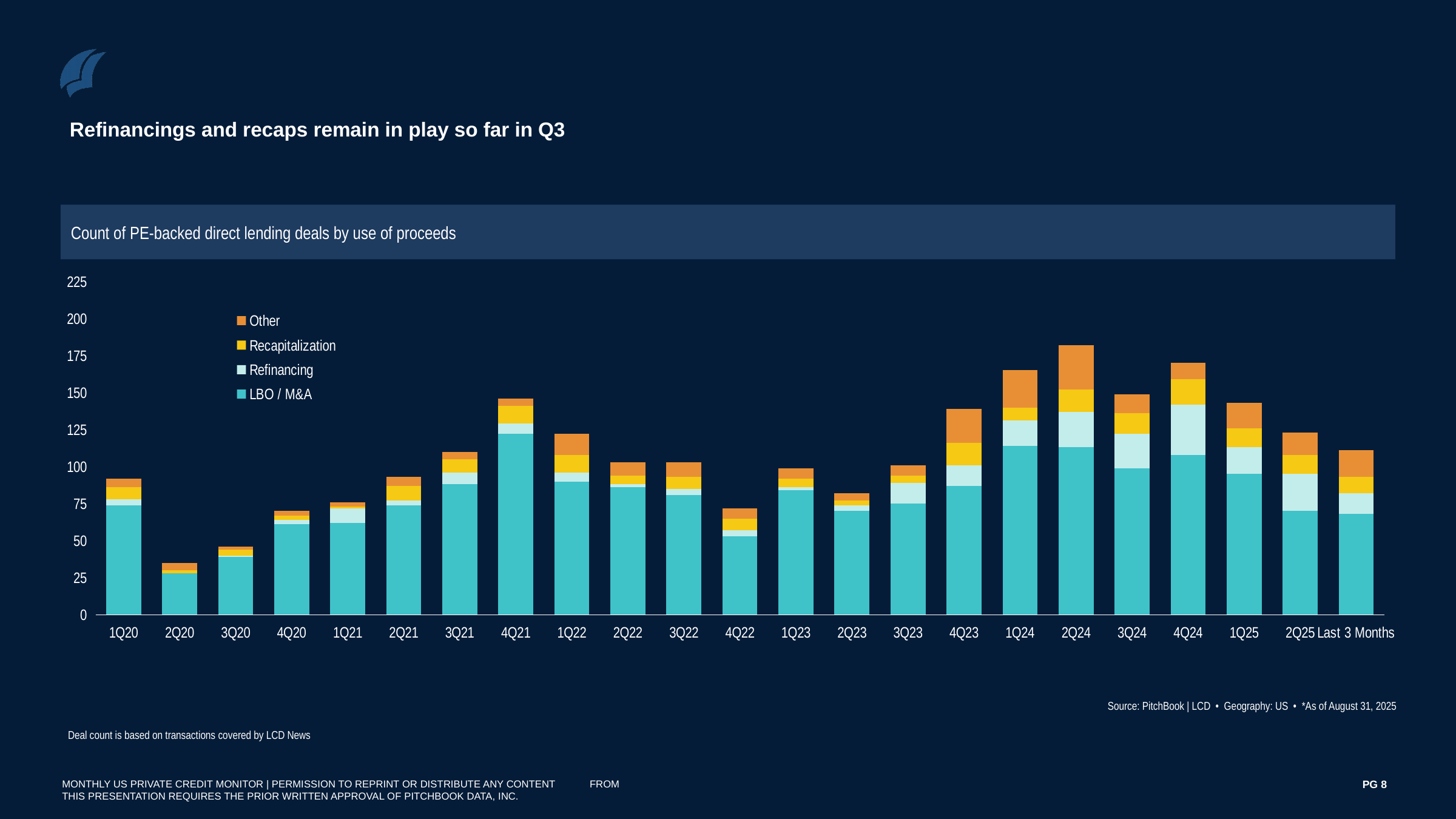
How many series does the legend list? 4 Is the total deal count for 2Q20 greater or less than 50? less Is the total deal count for 3Q21 greater or less than 100? greater Which period has the highest total deal count? 2Q24 What kind of chart is shown on the slide? Stacked bar chart Which period has the lowest total deal count? 2Q20 Is the total deal count for the Last 3 Months bar greater or less than 100? greater Which period has a higher total deal count, 1Q22 or 2Q22? 1Q22 How many bars (periods) are plotted along the x axis? 23 Which series is shown at the bottom of each stacked bar? LBO / M&A Do total deal counts rise or fall from 2Q20 to 4Q21? rise